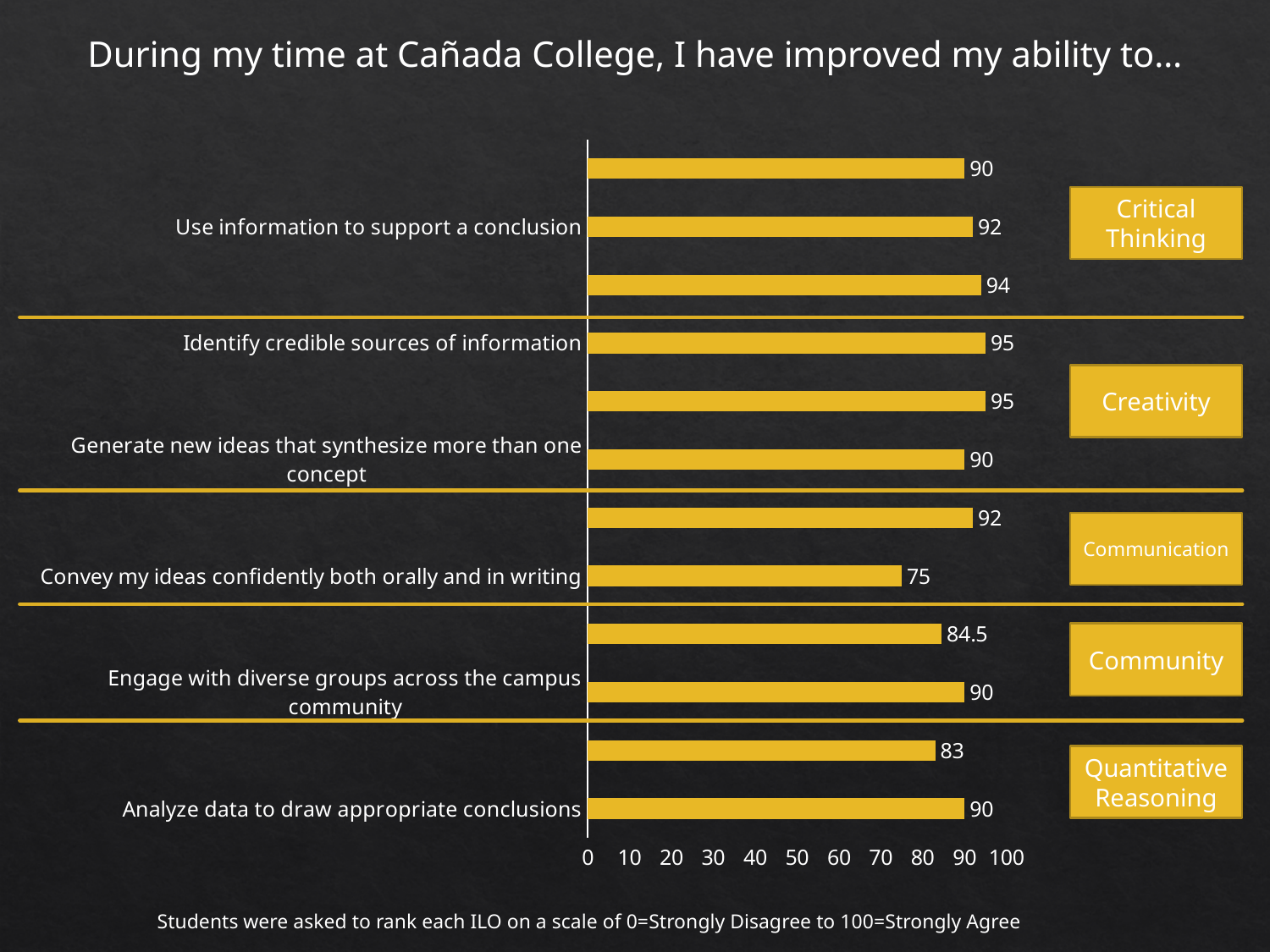
What is the value for "Identify credible sources of information"? 95 What is the value for "Generate new ideas that synthesize more than one concept"? 90 What is the difference between the values for "Identify credible sources of information" and "Convey my ideas confidently both orally and in writing"? 20 What is the value for "Engage with diverse groups across the campus community"? 90 How many ILO group labels (such as Critical Thinking and Creativity) are shown to the right of the chart? 5 How many bars are plotted in the chart? 12 What kind of chart is shown on the slide? bar chart Which labeled item has the lowest value? Convey my ideas confidently both orally and in writing What is the value for "Analyze data to draw appropriate conclusions"? 90 What is the value for "Convey my ideas confidently both orally and in writing"? 75 What is the value for "Use information to support a conclusion"? 92 Which has a larger value: "Use information to support a conclusion" or "Convey my ideas confidently both orally and in writing"? Use information to support a conclusion